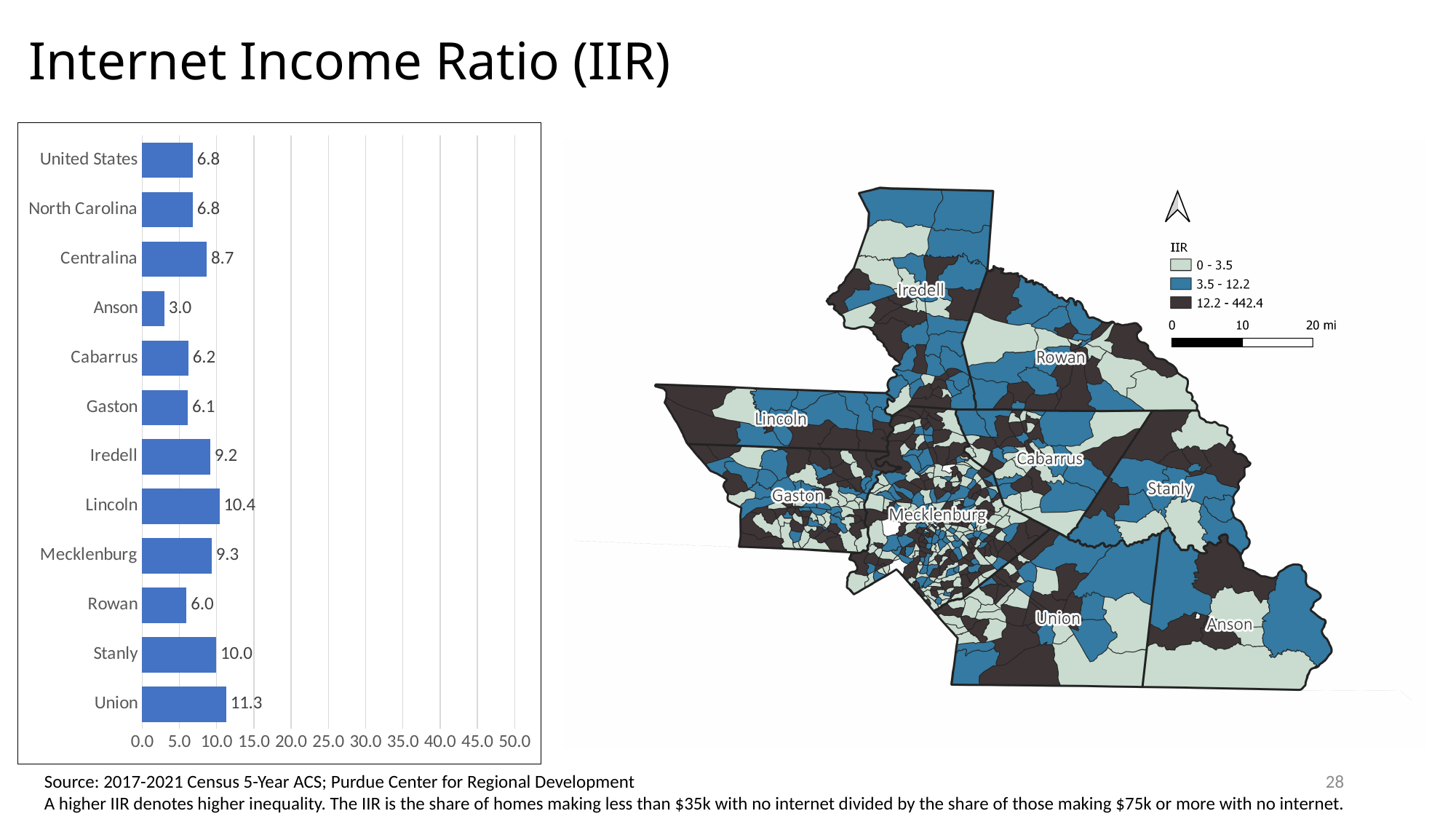
Which category has the highest value in the bar chart? Union Which has a larger value in the bar chart, Iredell or Cabarrus? Iredell What is the difference between the values for Union and Anson in the bar chart? 8.3 What is the Internet Income Ratio value for Union in the bar chart? 11.3 Which category has the lowest value in the bar chart? Anson What kind of chart is shown on the left of the slide? bar chart Is the value for Mecklenburg in the bar chart greater or less than 5.0? greater What is the value shown for Lincoln in the bar chart? 10.4 What is the value shown for Centralina in the bar chart? 8.7 How many categories are shown in the bar chart? 12 What are the three IIR ranges listed in the map legend? 0 - 3.5, 3.5 - 12.2, 12.2 - 442.4 What is the difference between the values for Lincoln and Stanly in the bar chart? 0.4